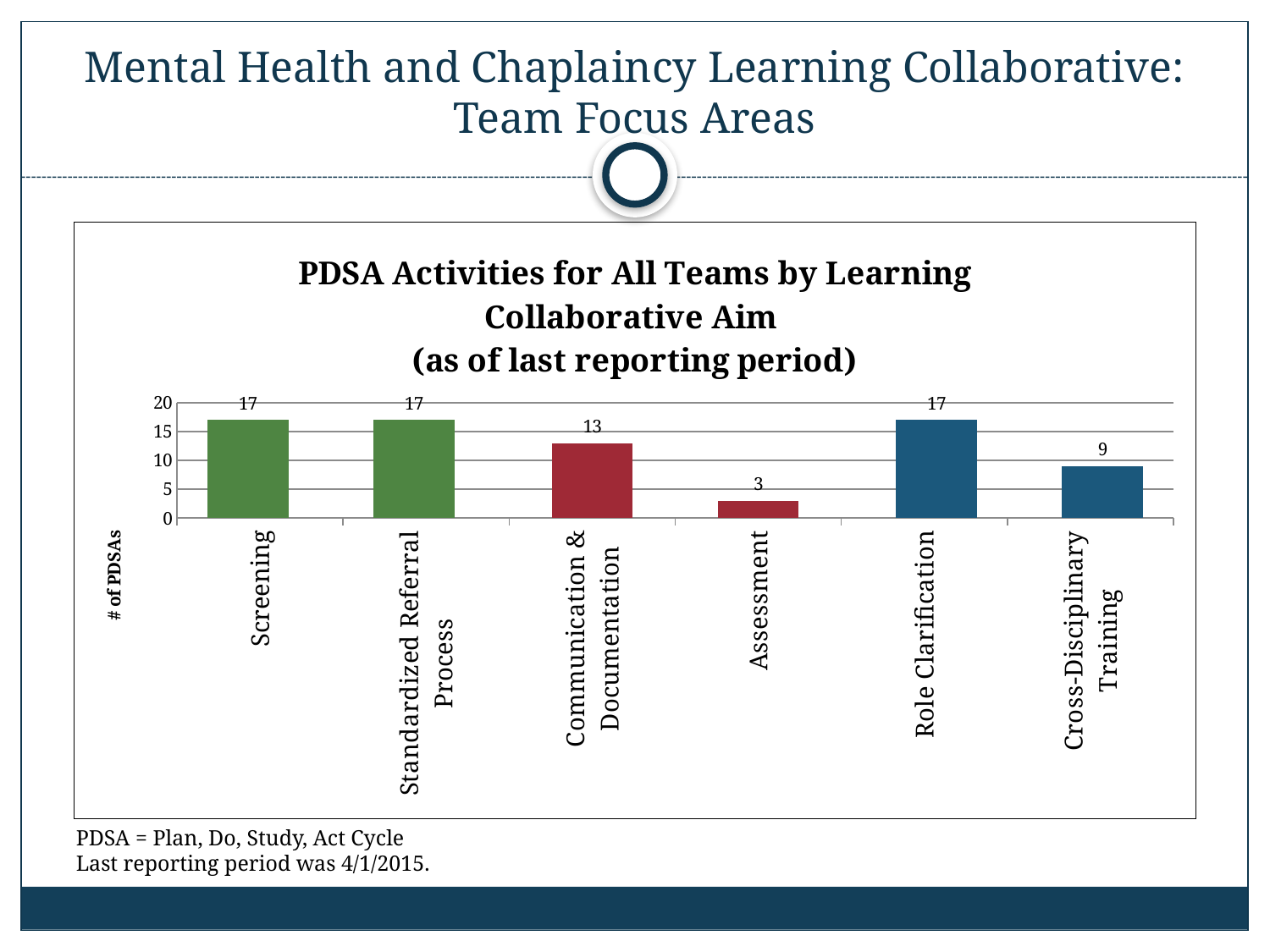
What is the number of PDSAs for Screening? 17 What kind of chart is shown on the slide? Bar chart What is the number of PDSAs for Communication & Documentation? 13 Which category has the lowest number of PDSAs? Assessment Which has more PDSAs, Communication & Documentation or Cross-Disciplinary Training? Communication & Documentation Is the value for Cross-Disciplinary Training greater or less than 10? less What is the difference in PDSAs between Communication & Documentation and Assessment? 10 How many categories are shown on the x axis? 6 What is the number of PDSAs for Cross-Disciplinary Training? 9 What is the label of the y axis? # of PDSAs What is the number of PDSAs for Assessment? 3 What is the difference in PDSAs between Role Clarification and Cross-Disciplinary Training? 8